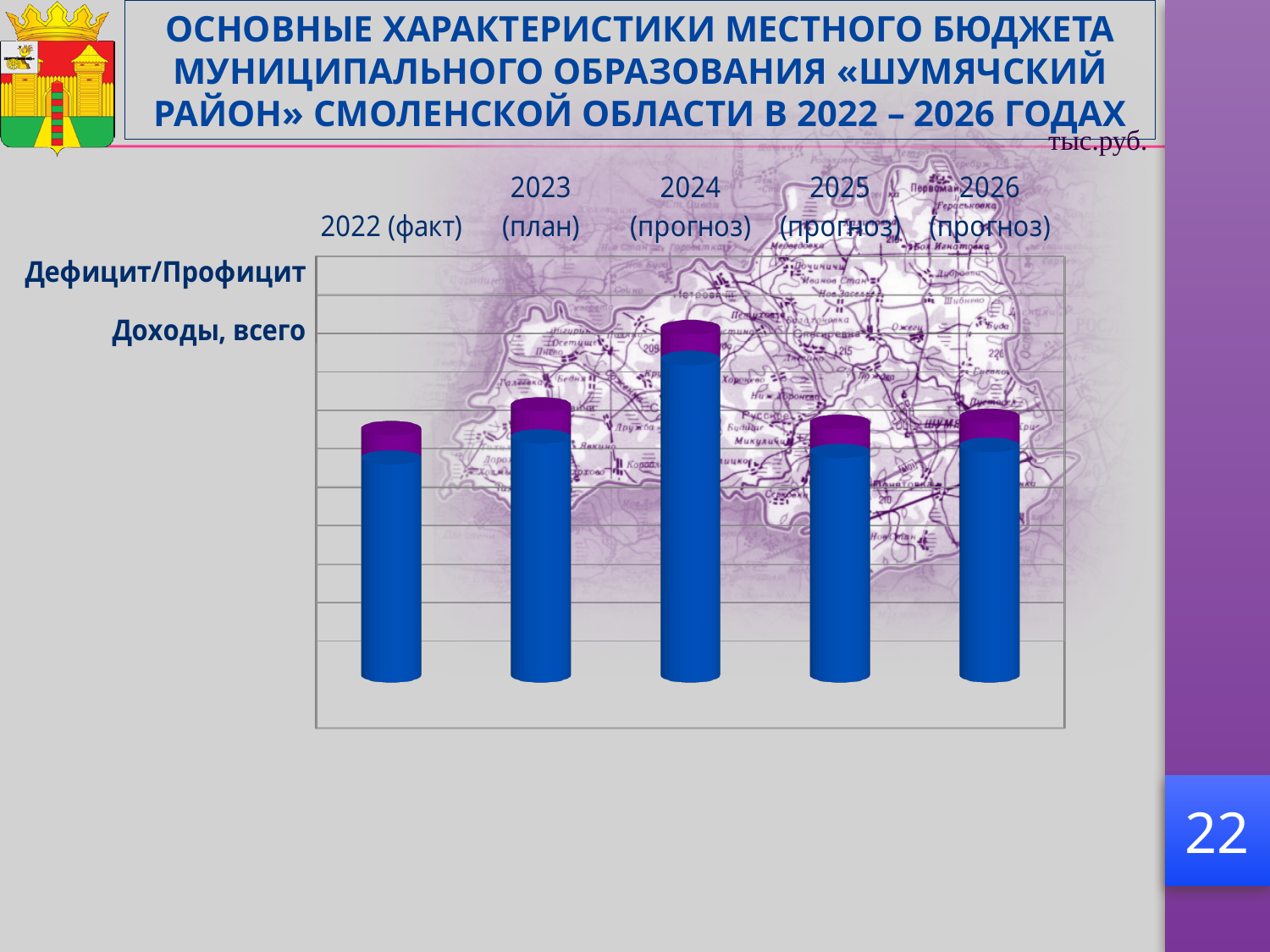
Which bar is taller, 2023 (план) or 2022 (факт)? 2023 (план) Do the bars rise or fall from 2024 (прогноз) to 2025 (прогноз)? fall Do the bars rise or fall from 2022 (факт) to 2024 (прогноз)? rise What unit of measurement is indicated for the chart? тыс.руб. What kind of chart is shown on the slide? bar chart Which bar is taller, 2024 (прогноз) or 2022 (факт)? 2024 (прогноз) Which year has the tallest bar on the chart? 2024 (прогноз) How many year categories are plotted on the chart? 5 Which bar is taller, 2024 (прогноз) or 2025 (прогноз)? 2024 (прогноз)